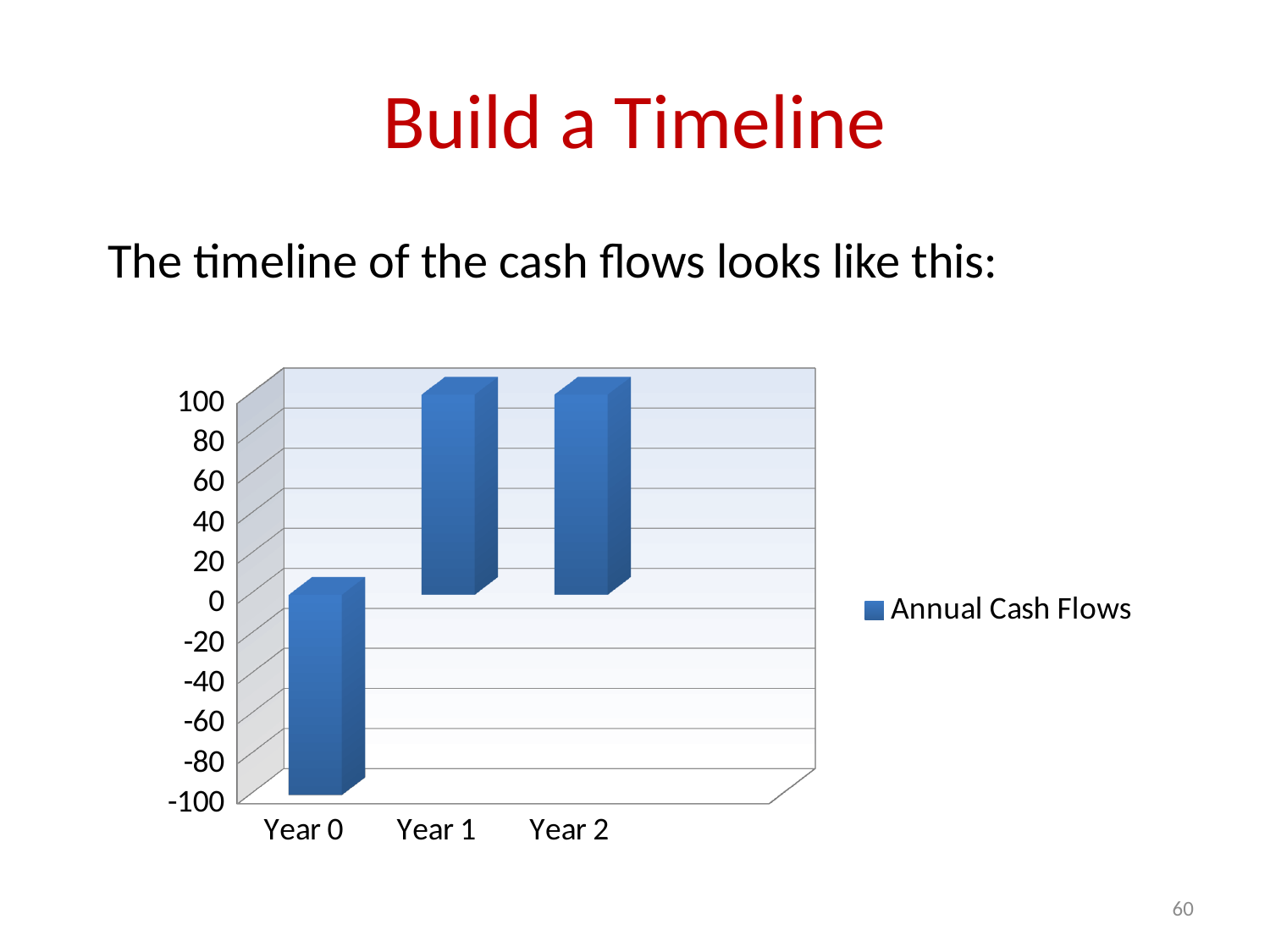
How many categories are shown on the x axis of the chart? 3 Is the value for Year 1 greater or less than 80? greater Is the value for Year 2 greater or less than 60? greater Which is larger, the value for Year 2 or the value for Year 0? Year 2 What is the name of the series shown in the chart's legend? Annual Cash Flows Is the value for Year 0 greater or less than -80? less Which category has the lowest value in the chart? Year 0 How many series does the chart's legend list? 1 Which is larger, the value for Year 0 or the value for Year 1? Year 1 What is the lowest value shown on the chart's vertical axis? -100 What kind of chart is shown on the slide? bar chart